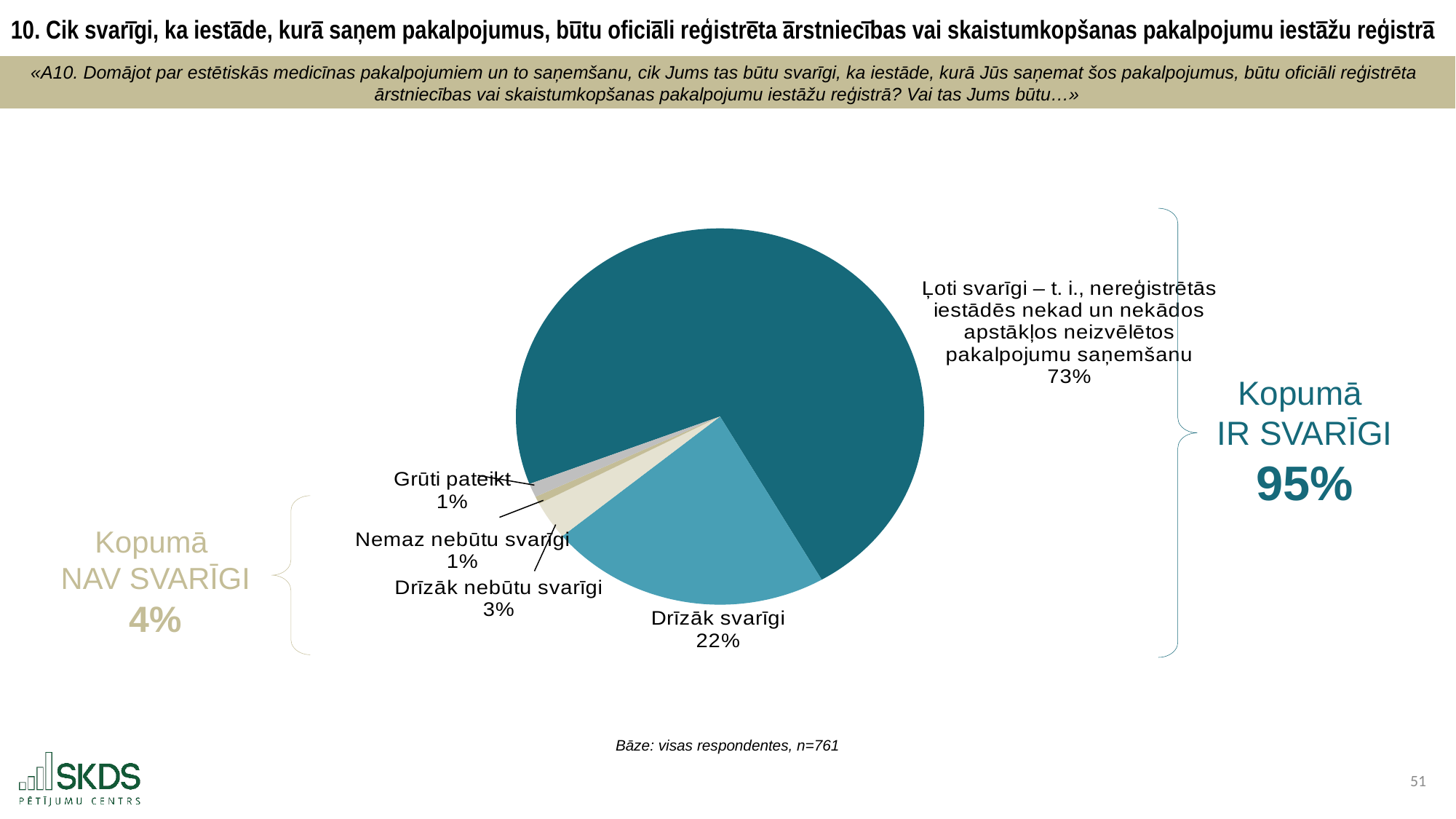
What combined percentage is shown for "Kopumā IR SVARĪGI"? 95% Which response category has the largest share of the pie? Ļoti svarīgi What type of chart is shown on the slide? pie chart What is the difference in percentage points between the "Ļoti svarīgi" slice and the "Drīzāk svarīgi" slice? 51 What percentage of respondents answered "Nemaz nebūtu svarīgi"? 1% How many slices does the pie chart have? 5 What is the sample size (n) stated in the base note below the chart? n=761 What percentage of respondents answered "Grūti pateikt"? 1% What percentage of respondents answered "Drīzāk svarīgi"? 22% What percentage of respondents answered "Drīzāk nebūtu svarīgi"? 3% Which is larger: the share for "Drīzāk svarīgi" or the share for "Drīzāk nebūtu svarīgi"? Drīzāk svarīgi What combined percentage is shown for "Kopumā NAV SVARĪGI"? 4%